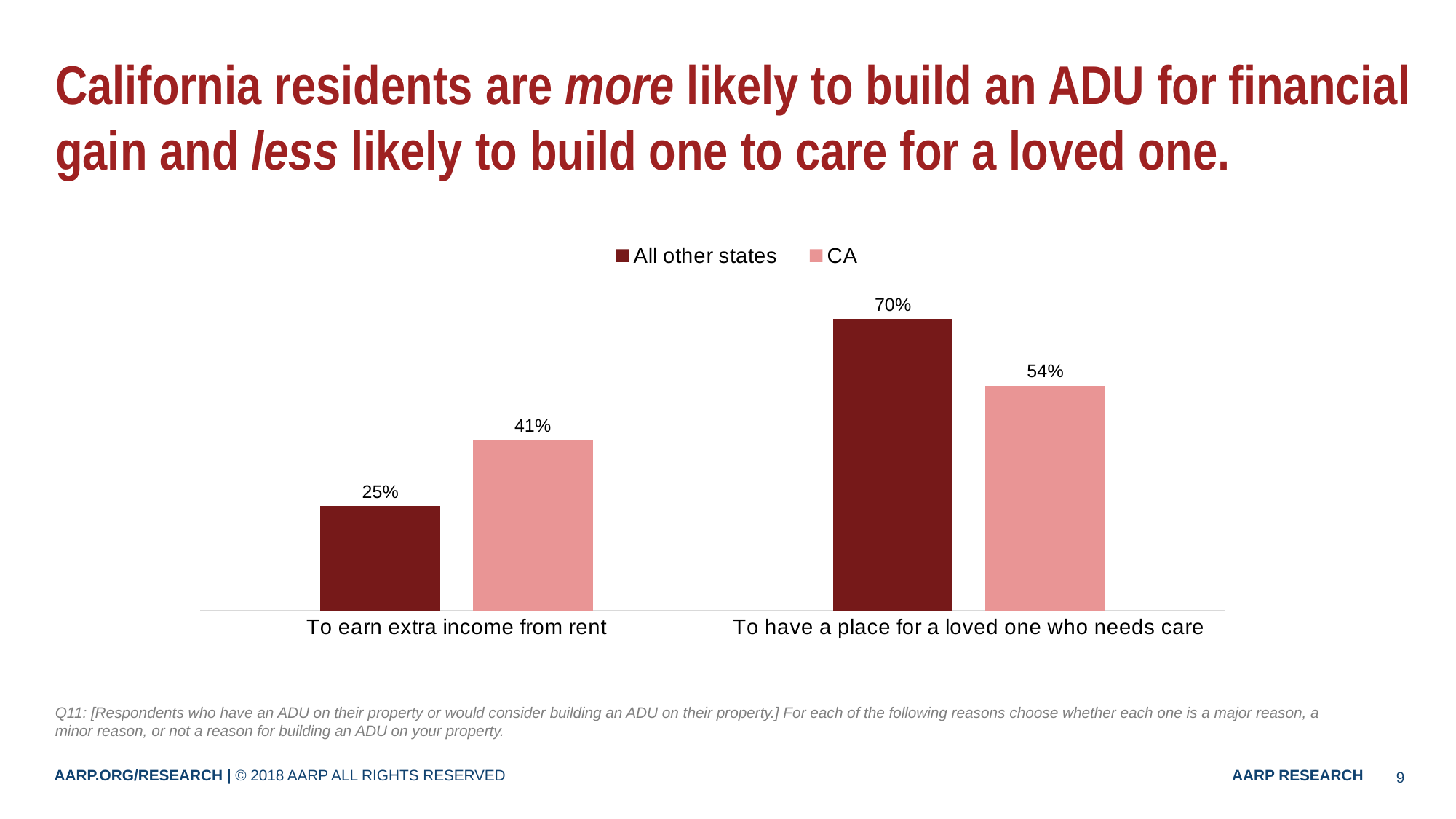
For "To have a place for a loved one who needs care", which is larger: All other states or CA? All other states How many categories are shown on the x axis? 2 What is the difference between CA and All other states for "To earn extra income from rent"? 16% Which bar has the lowest value on the chart? All other states, To earn extra income from rent Which bar has the highest value on the chart? All other states, To have a place for a loved one who needs care How many series does the legend list? 2 What is the value for All other states for "To earn extra income from rent"? 25% What is the difference between All other states and CA for "To have a place for a loved one who needs care"? 16% What is the value for CA for "To have a place for a loved one who needs care"? 54% What is the value for All other states for "To have a place for a loved one who needs care"? 70% What kind of chart is shown on the slide? Bar chart What is the value for CA for "To earn extra income from rent"? 41%